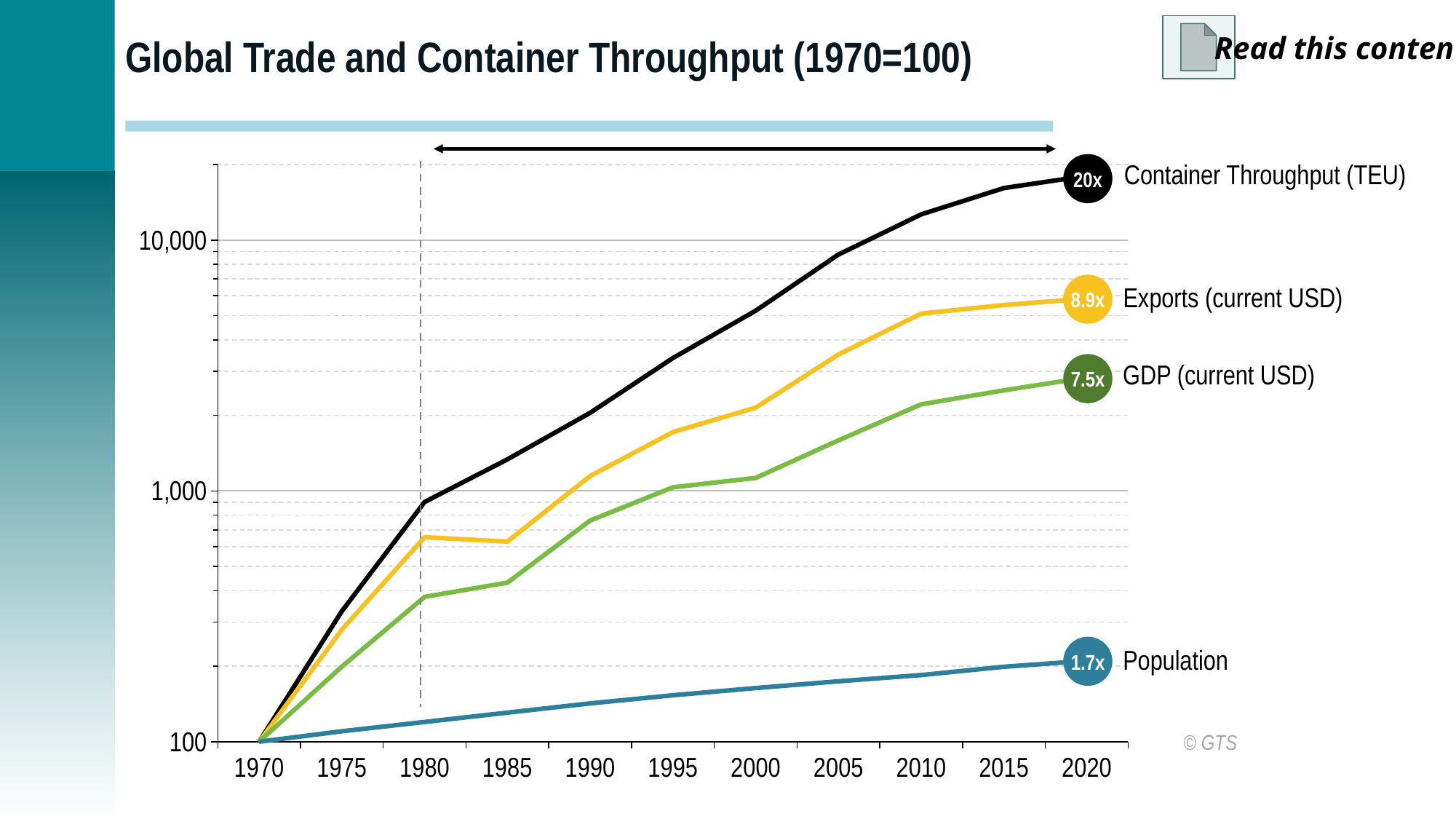
Which is larger at the end of the period, Exports (current USD) or GDP (current USD)? Exports (current USD) What multiplier label is shown at the end of the GDP (current USD) line? 7.5x What multiplier label is shown at the end of the Population line? 1.7x Which series has the lowest value at the end of the period? Population What multiplier label is shown at the end of the Container Throughput (TEU) line? 20x Is the value for Exports (current USD) in 1980 greater or less than 1,000? less What kind of chart is shown on the slide? line chart How many series are plotted on the chart? 4 Is the value for Container Throughput (TEU) in 2010 greater or less than 10,000? greater What multiplier label is shown at the end of the Exports (current USD) line? 8.9x What is the title of the chart? Global Trade and Container Throughput (1970=100) Which series has the highest value at the end of the period? Container Throughput (TEU)